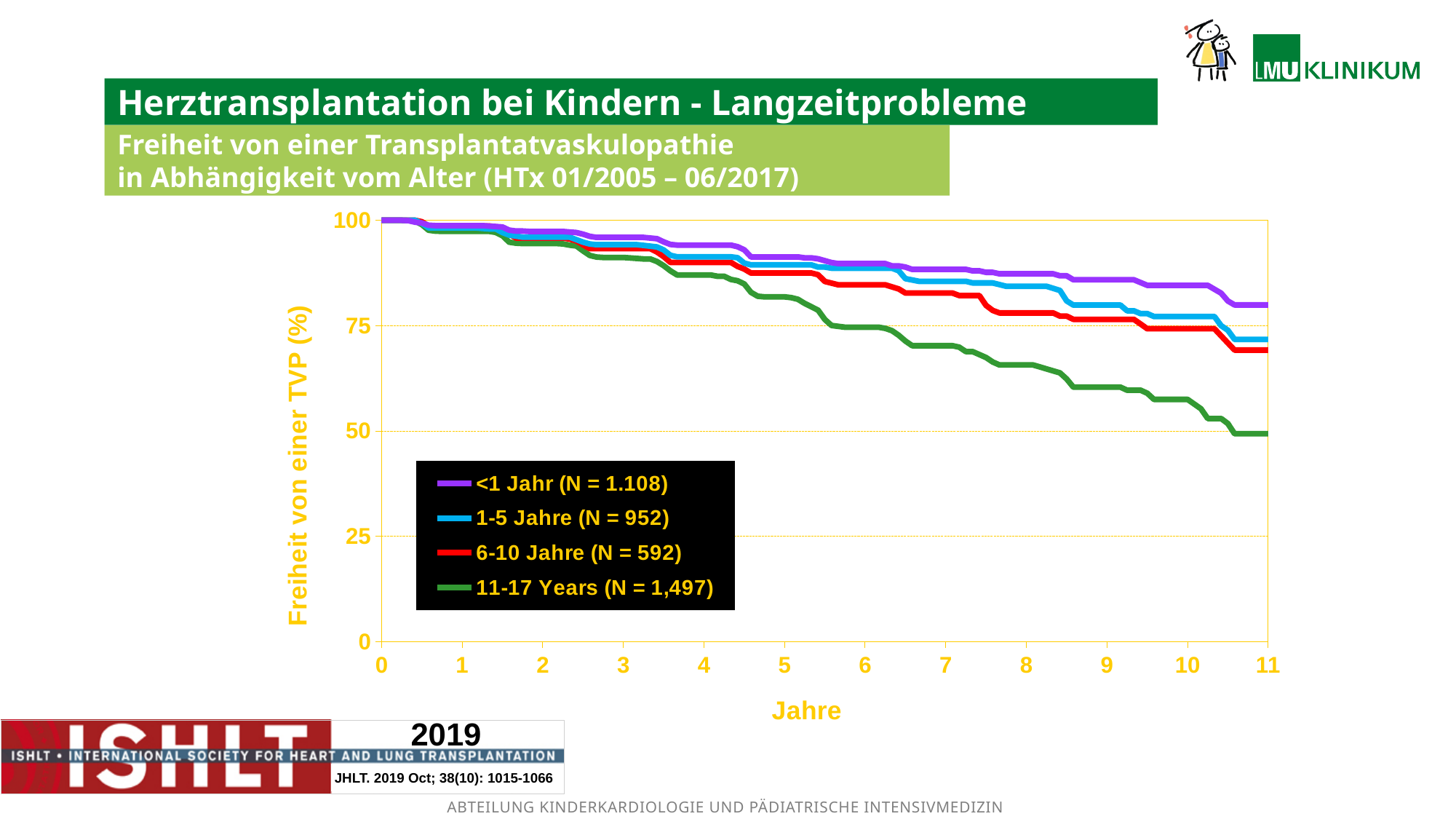
Which series has the lowest value at 11 years? 11-17 Years At 8 years, which series has the larger value, 1-5 Jahre or 11-17 Years? 1-5 Jahre Is the value for 11-17 Years at 10 years greater or less than 50? greater Is the value for 1-5 Jahre at 5 years greater or less than 75? greater Do the values rise or fall along the x axis? fall What are the entries listed in the legend? <1 Jahr (N = 1.108), 1-5 Jahre (N = 952), 6-10 Jahre (N = 592), 11-17 Years (N = 1,497) Is the value for 6-10 Jahre at 11 years greater or less than 75? less What N is given in the legend for the 11-17 Years series? 1,497 How many series does the legend list? 4 What kind of chart is shown on the slide? line chart Which series has the highest value at 11 years? <1 Jahr